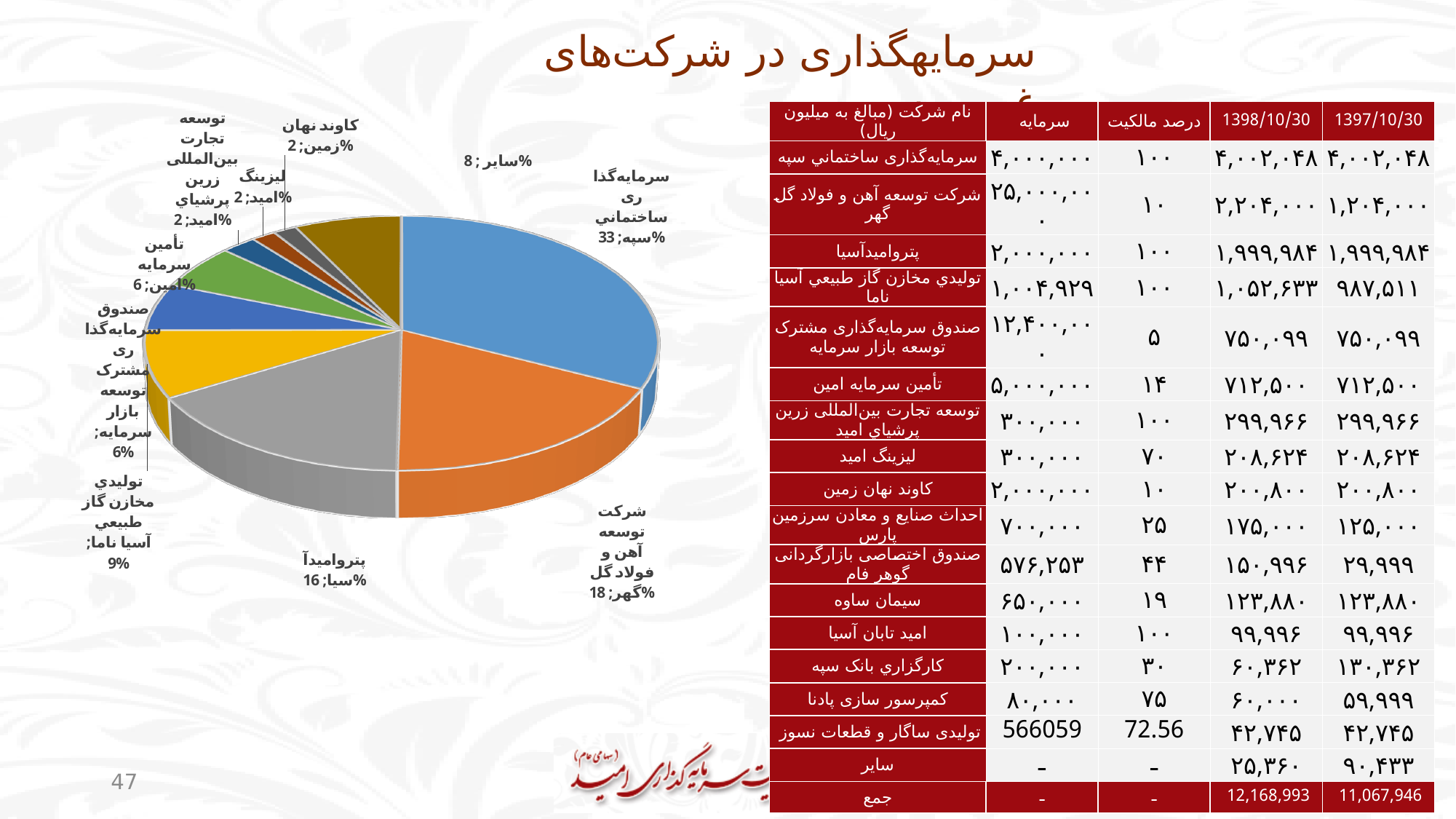
What share of the pie does لیزینگ امید hold? 2% How many slices does the pie chart have? 10 What is the difference in percentage points between the سپه slice and the گل گهر slice? 15 Which is larger in the pie chart, پتروامیدآسیا or تأمین سرمایه امین? پتروامیدآسیا What share of the pie does شرکت توسعه آهن و فولاد گل گهر hold? 18% What colour is the largest slice of the pie chart? Blue What share of the pie is labelled سایر? 8% What kind of chart is shown on the left of the slide? Pie chart Which slice of the pie chart is the largest? سرمایه‌گذاری ساختمانی سپه